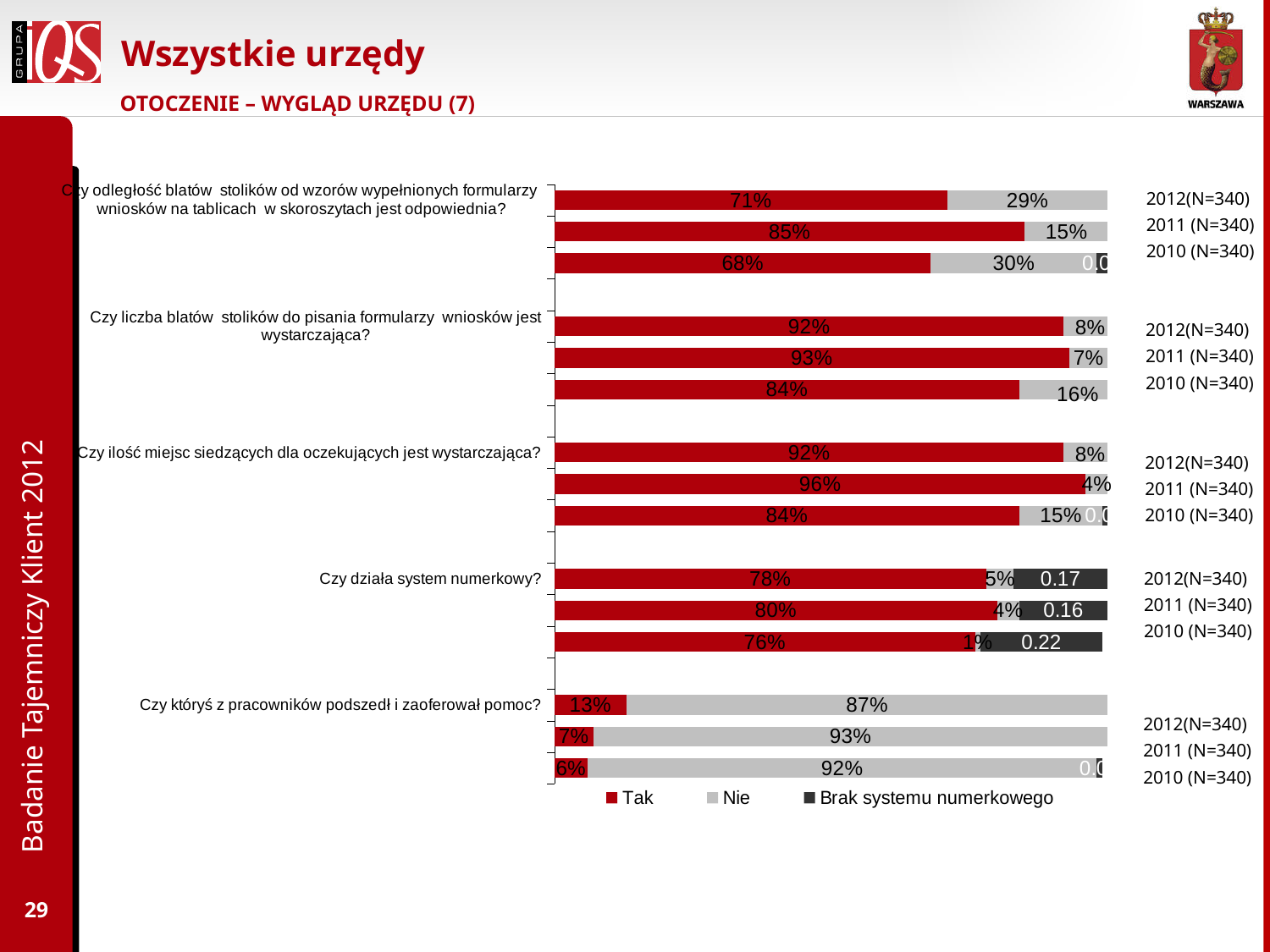
How many series does the legend list? 3 What is the 'Nie' value for 2012 for the question 'Czy któryś z pracowników podszedł i zaoferował pomoc?' 87% What kind of chart is shown on the slide? stacked bar chart For the question 'Czy któryś z pracowników podszedł i zaoferował pomoc?', is the 'Tak' value higher in 2012 or in 2010? 2012 For the question 'Czy odległość blatów stolików od wzorów wypełnionych formularzy wniosków na tablicach w skoroszytach jest odpowiednia?', what is the difference between the 'Tak' values for 2011 and 2012? 14% For the question 'Czy liczba blatów stolików do pisania formularzy wniosków jest wystarczająca?', which year has the lowest 'Tak' value? 2010 (N=340) What is the 'Tak' value for 2011 for the question 'Czy ilość miejsc siedzących dla oczekujących jest wystarczająca?' 96% What is the 'Tak' value for 2012 for the question 'Czy działa system numerkowy?' 78% What is the 'Nie' value for 2010 for the question 'Czy odległość blatów stolików od wzorów wypełnionych formularzy wniosków na tablicach w skoroszytach jest odpowiednia?' 30% How many survey questions (categories) are shown on the chart? 5 Which legend entry is shown in red? Tak What is the 'Brak systemu numerkowego' value for 2010 for the question 'Czy działa system numerkowy?' 0.22